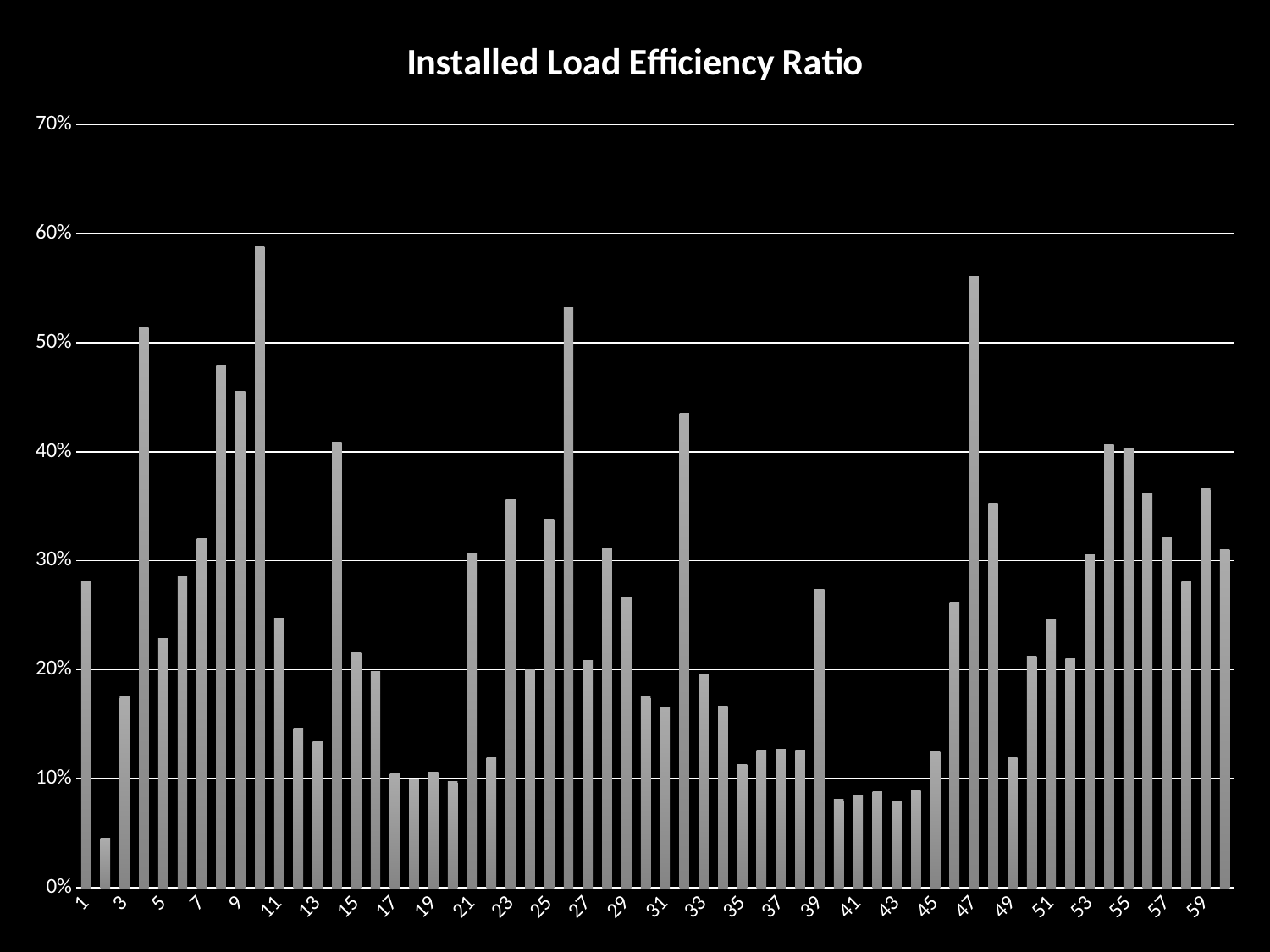
Which has the larger value, category 4 or category 47? 47 What kind of chart is shown on the slide? bar chart What is the title of the chart? Installed Load Efficiency Ratio Is the value for category 32 greater or less than 40%? greater Is the value for category 47 greater or less than 50%? greater Is the value for category 2 greater or less than 10%? less Which category has the highest Installed Load Efficiency Ratio? 10 How many bars (categories) are plotted in the chart? 60 Which has the larger value, category 14 or category 15? 14 Which category has the lowest Installed Load Efficiency Ratio? 2